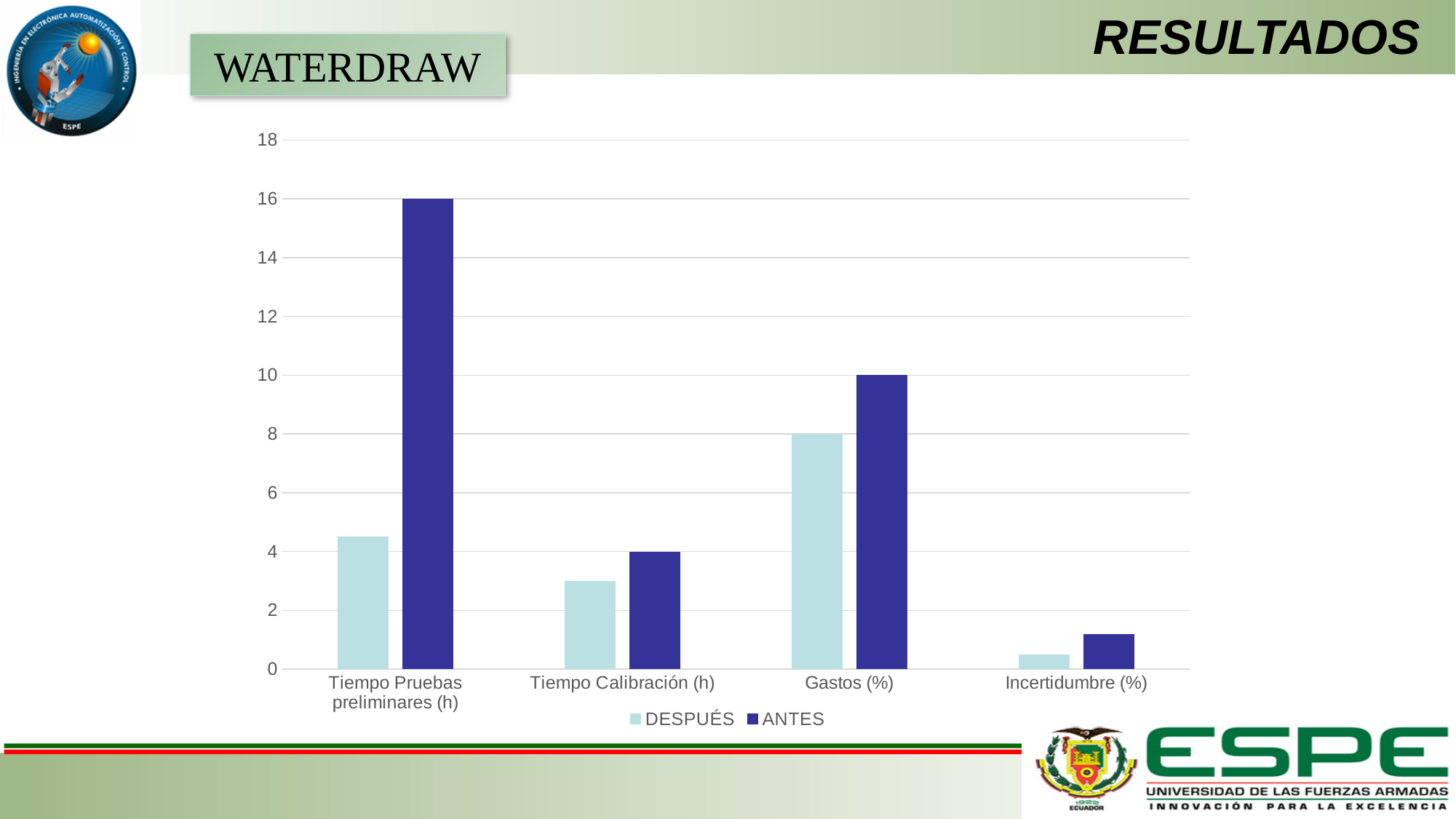
How many categories are shown on the x axis? 4 What is the ANTES value for Tiempo Calibración (h)? 4 Which category has the lowest DESPUÉS value? Incertidumbre (%) What is the ANTES value for Gastos (%)? 10 What is the ANTES value for Tiempo Pruebas preliminares (h)? 16 How many series does the legend list? 2 Is the DESPUÉS value for Tiempo Calibración (h) greater or less than 4? less What is the DESPUÉS value for Gastos (%)? 8 Which category has the highest ANTES value? Tiempo Pruebas preliminares (h) What is the difference between the ANTES and DESPUÉS values for Gastos (%)? 2 Which series is shown in dark blue in the legend? ANTES What type of chart is shown on the slide? bar chart